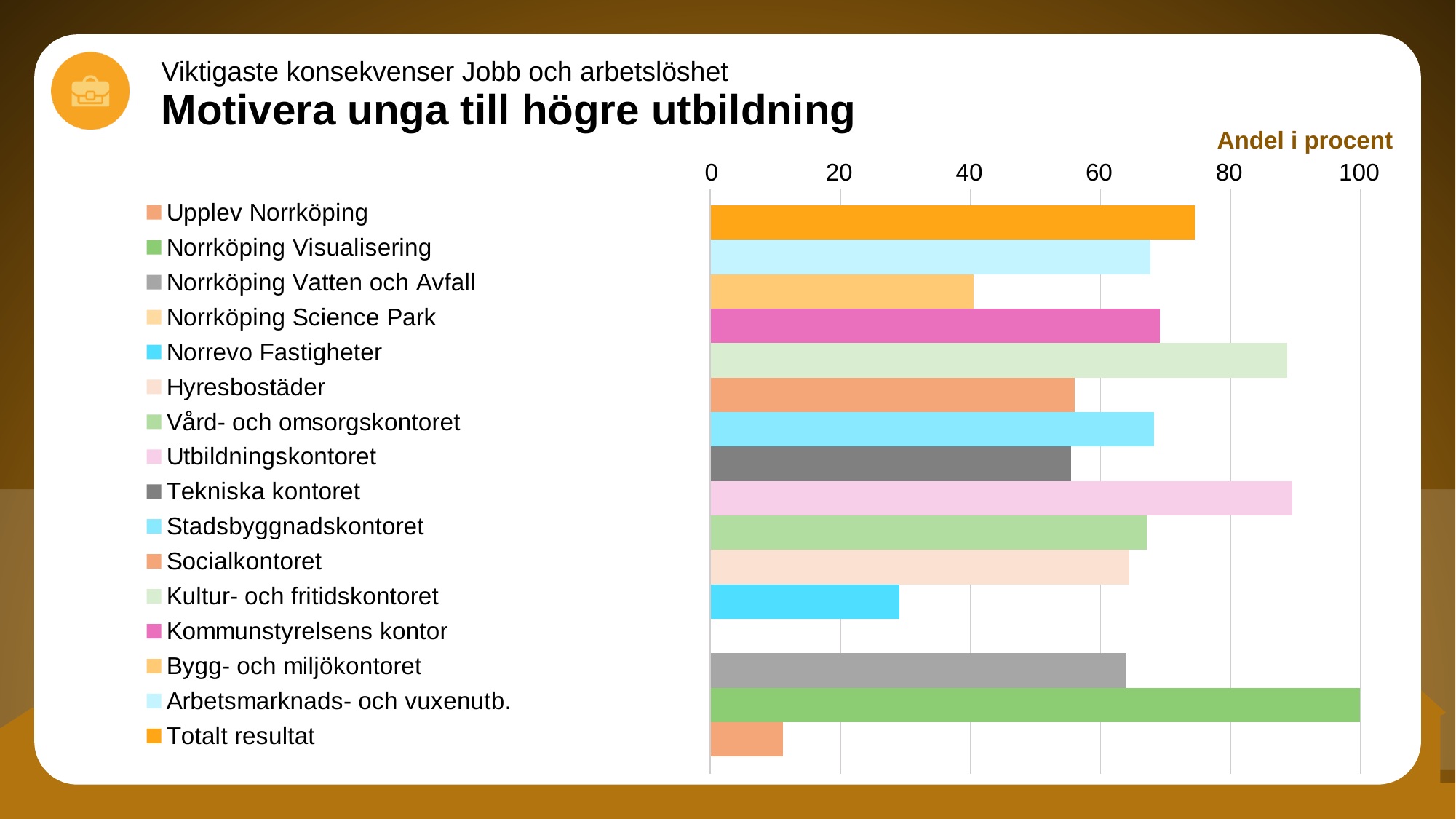
What is the title shown above the horizontal axis of the chart? Andel i procent Which category has the highest value in the chart? Norrköping Visualisering Is the value for Upplev Norrköping greater or less than 20? less Is the value for Norrevo Fastigheter greater or less than 40? less What is the highest tick value shown on the horizontal axis? 100 Which is larger, the value for Kultur- och fritidskontoret or the value for Socialkontoret? Kultur- och fritidskontoret Is the value for Kultur- och fritidskontoret greater or less than 80? greater Which is larger, the value for Bygg- och miljökontoret or the value for Norrevo Fastigheter? Bygg- och miljökontoret What kind of chart is shown on the slide? bar chart How many entries does the legend list? 16